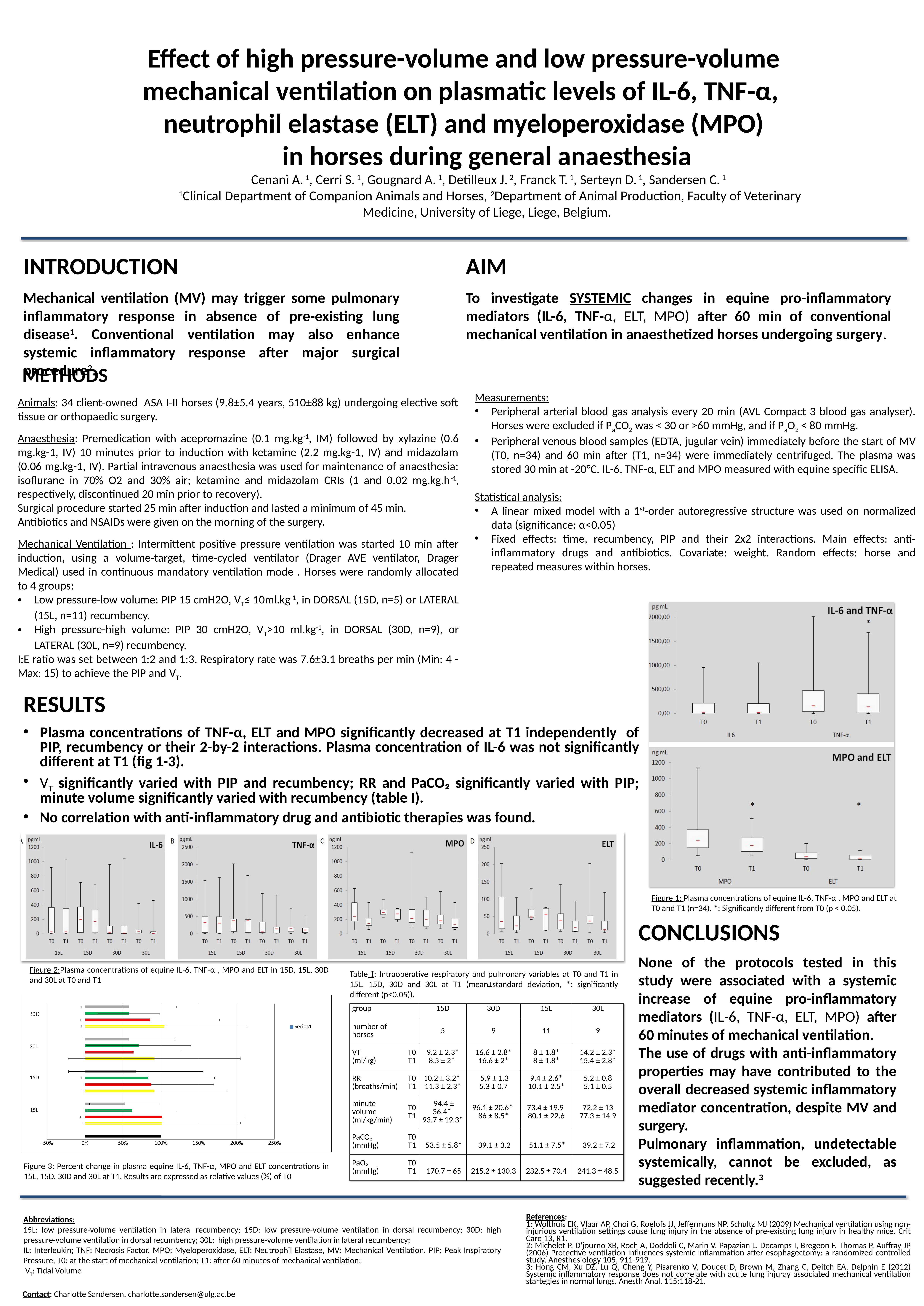
In the 'IL-6 and TNF-α' chart of Figure 1, is the top of the upper whisker for IL6 at T0 greater or less than 1500? less What kind of chart is Figure 3 (the chart showing percent change in 15L, 15D, 30D and 30L)? bar chart How many group categories are shown on the y axis of Figure 3? 4 What kind of chart is the 'IL-6 and TNF-α' chart in Figure 1? box plot In panel D (ELT) of Figure 2, how many recumbency/pressure groups are shown on the x axis? 4 In the 'MPO and ELT' chart of Figure 1, is the top of the upper whisker for MPO at T0 greater or less than 1000? greater In panel C (MPO) of Figure 2, is the top of the upper whisker for 15D at T1 greater or less than 1000? greater How many series does the legend of Figure 3 list? 1 What unit is shown on the y axis of the 'MPO and ELT' chart in Figure 1? ng mL In the 'MPO and ELT' chart of Figure 1, which box has the highest upper whisker? MPO T0 In the 'IL-6 and TNF-α' chart of Figure 1, which category is marked with an asterisk? TNF-α T1